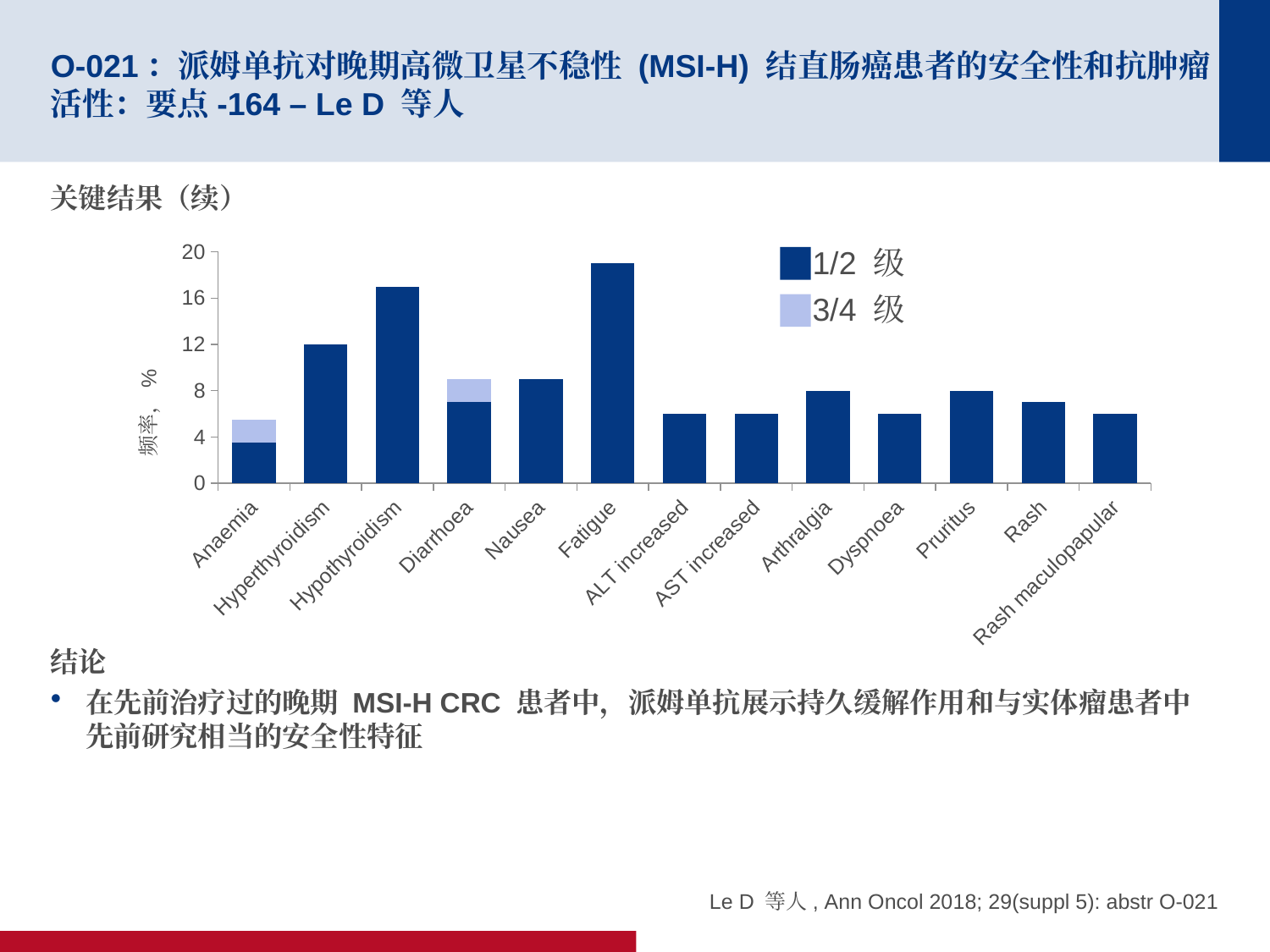
How many series does the legend list? 2 Which category has the highest total frequency? Fatigue Which is larger, the value for Hyperthyroidism or the value for Nausea? Hyperthyroidism Which categories show a 3/4 级 segment? Anaemia and Diarrhoea How many adverse event categories are shown on the x axis? 13 Is the value for Hypothyroidism greater or less than 16? greater Is the value for Nausea greater or less than 8? greater What kind of chart is shown on the slide? bar chart What is the label on the y axis? 频率, % Which category has the lowest 1/2 级 frequency? Anaemia Is the value for Fatigue greater or less than 16? greater